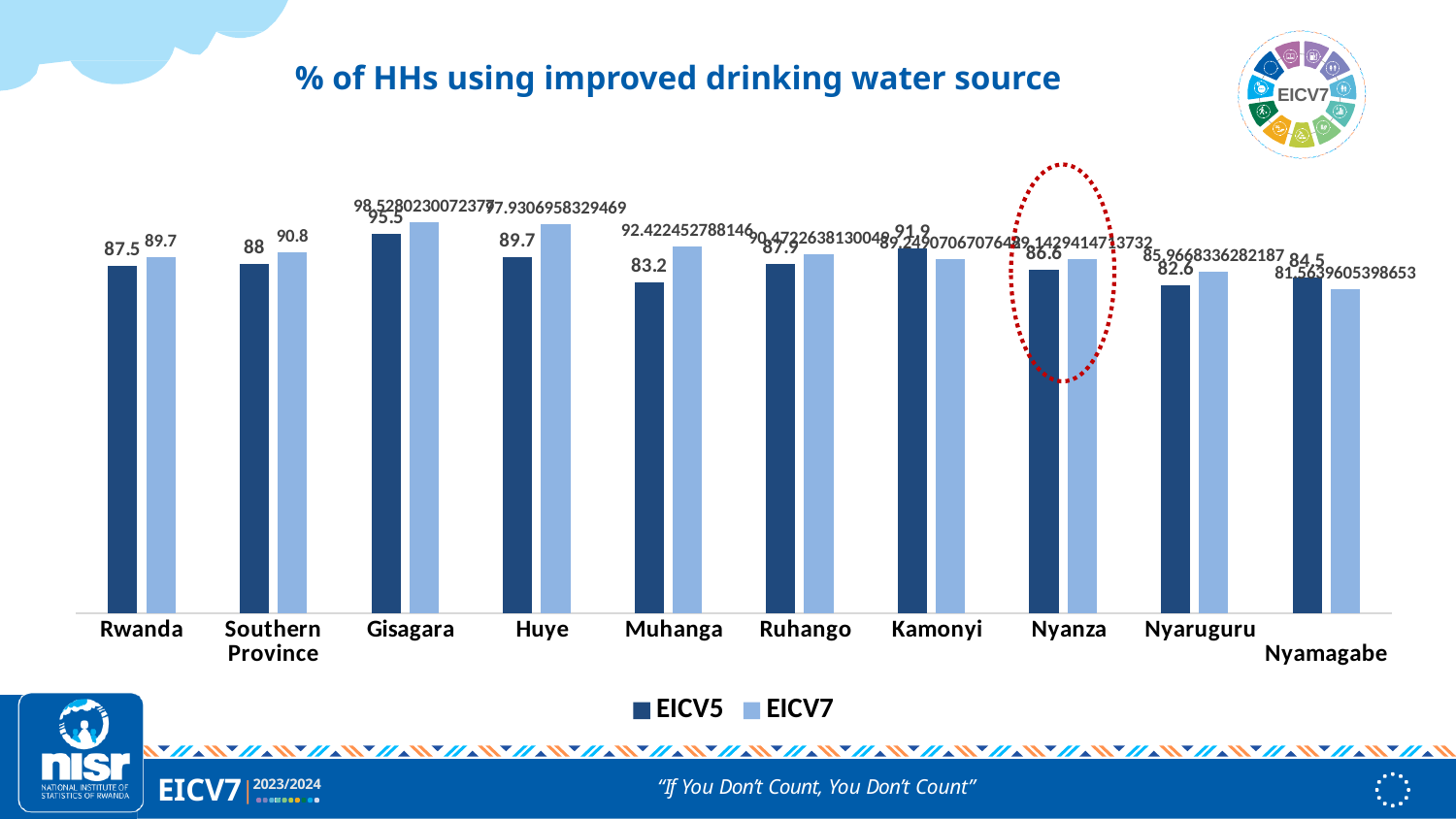
What is the EICV5 value for Rwanda? 87.5 What is the difference between the EICV7 and EICV5 values for Rwanda? 2.2 What kind of chart is shown on the slide? Bar chart How many series does the legend list? 2 Which category has the lowest EICV7 value? Nyamagabe Which category has the lowest EICV5 value? Nyaruguru How many categories are shown on the x axis? 10 What is the EICV5 value for Muhanga? 83.2 What is the EICV5 value for Gisagara? 95.5 What is the EICV7 value for Southern Province? 90.8 Which category has the highest EICV5 value? Gisagara For Nyamagabe, which is larger: the EICV5 value or the EICV7 value? EICV5